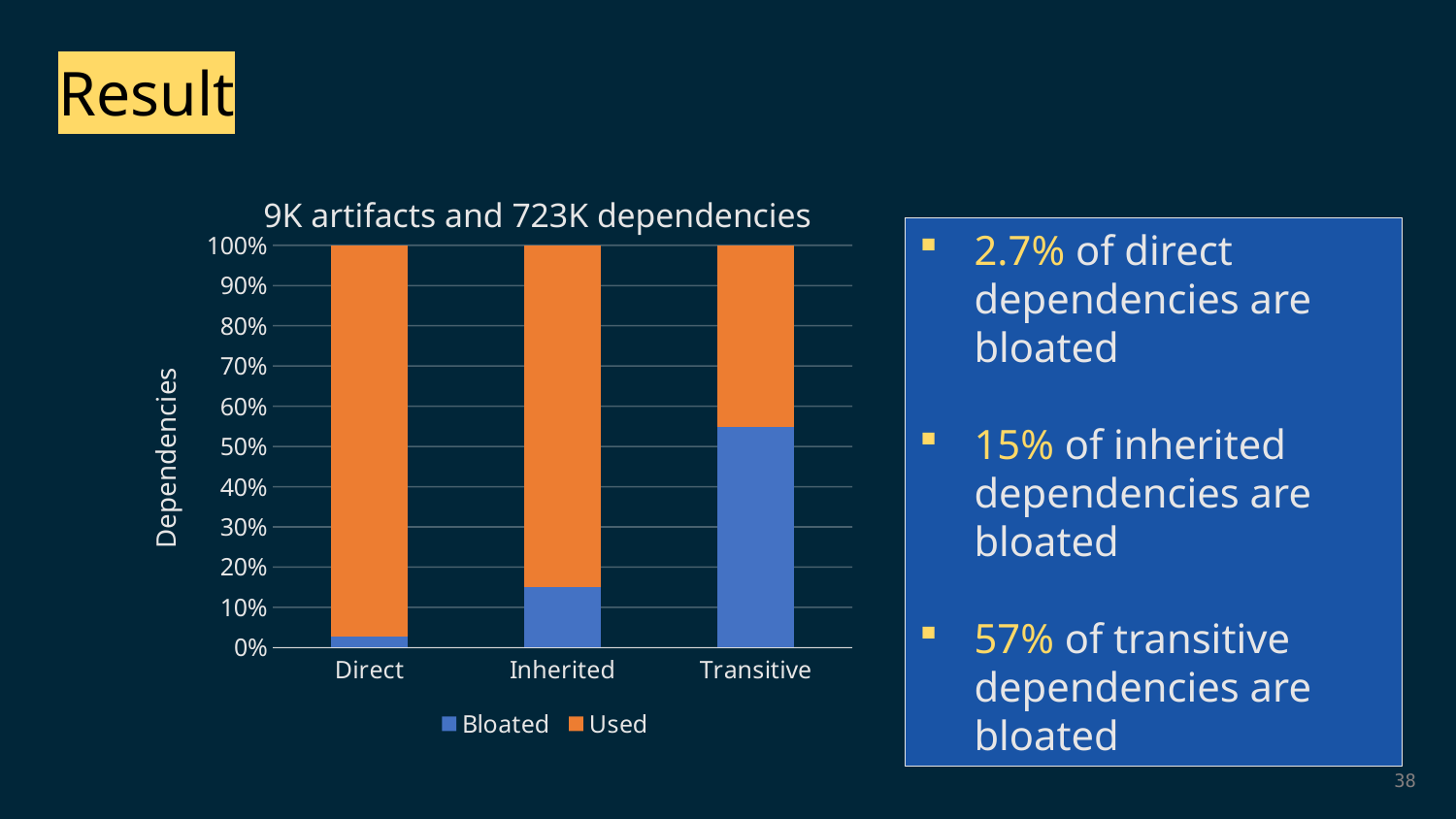
Which category has the highest share of Bloated dependencies? Transitive Is the Bloated share for Transitive dependencies greater or less than 50%? greater Is the Bloated share for Inherited dependencies greater or less than 20%? less How many categories are shown on the x axis of the chart? 3 How many series does the chart's legend list? 2 What kind of chart is shown on the slide? stacked bar chart Which category has the lowest share of Bloated dependencies? Direct Which series in the chart is shown in blue? Bloated According to the slide, what percentage of transitive dependencies are bloated? 57% Is the Used share for Direct dependencies greater or less than 90%? greater What is the title of the chart? 9K artifacts and 723K dependencies Which is larger, the Bloated share for Inherited or for Transitive dependencies? Transitive